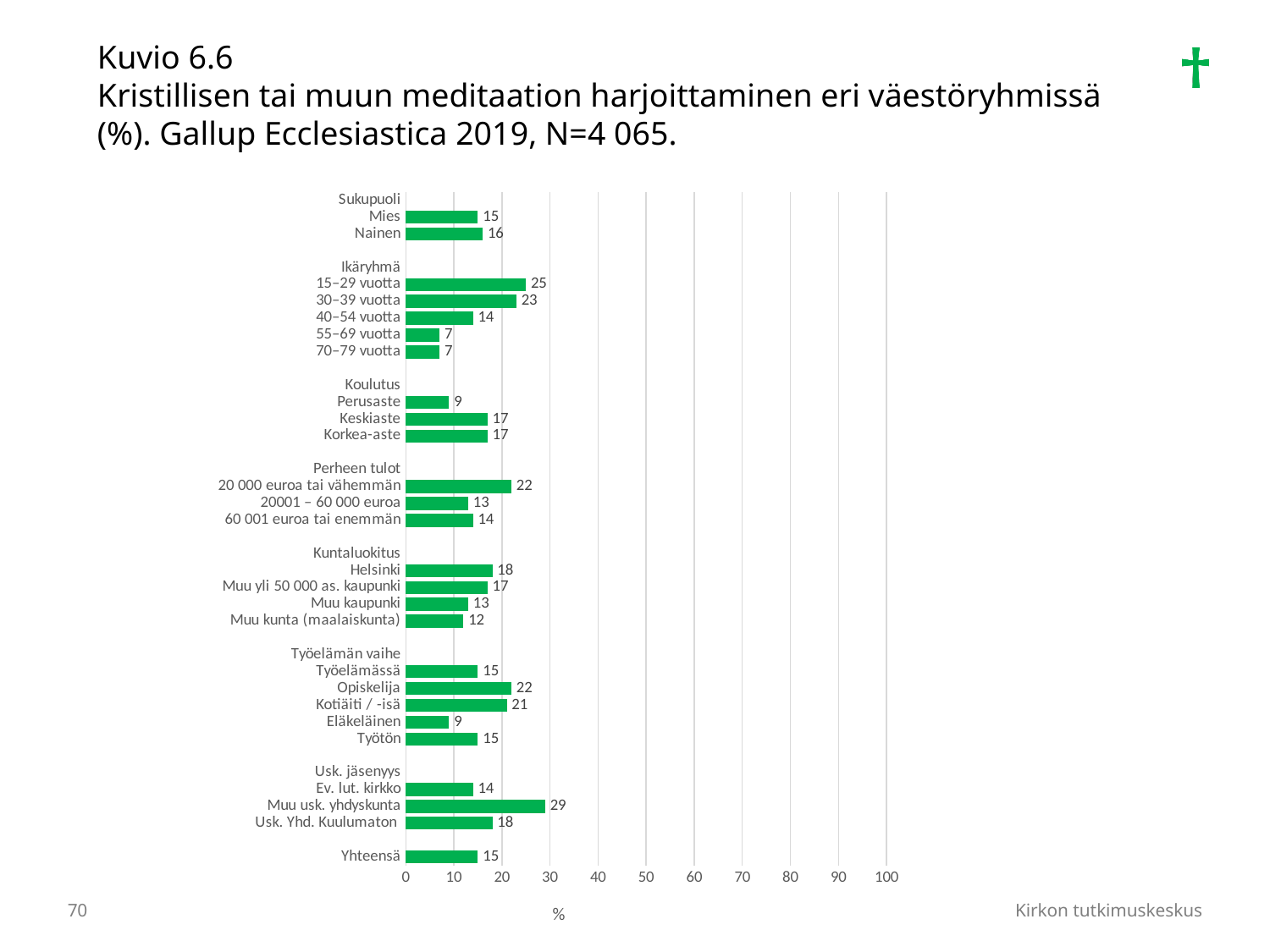
What is the label on the horizontal axis of the chart? % How many bars are plotted in the chart? 26 Which category has the highest value in the chart? Muu usk. yhdyskunta What is the value for Nainen? 16 What is the value for Opiskelija? 22 Within the Koulutus group, which category has the lowest value? Perusaste What is the value for Yhteensä? 15 What is the value for Muu usk. yhdyskunta? 29 Which is larger, the value for Helsinki or the value for Muu kunta (maalaiskunta)? Helsinki Is the value for Muu usk. yhdyskunta greater or less than 20? greater What kind of chart is shown on the slide? Bar chart What is the difference between the values for 15–29 vuotta and 70–79 vuotta? 18